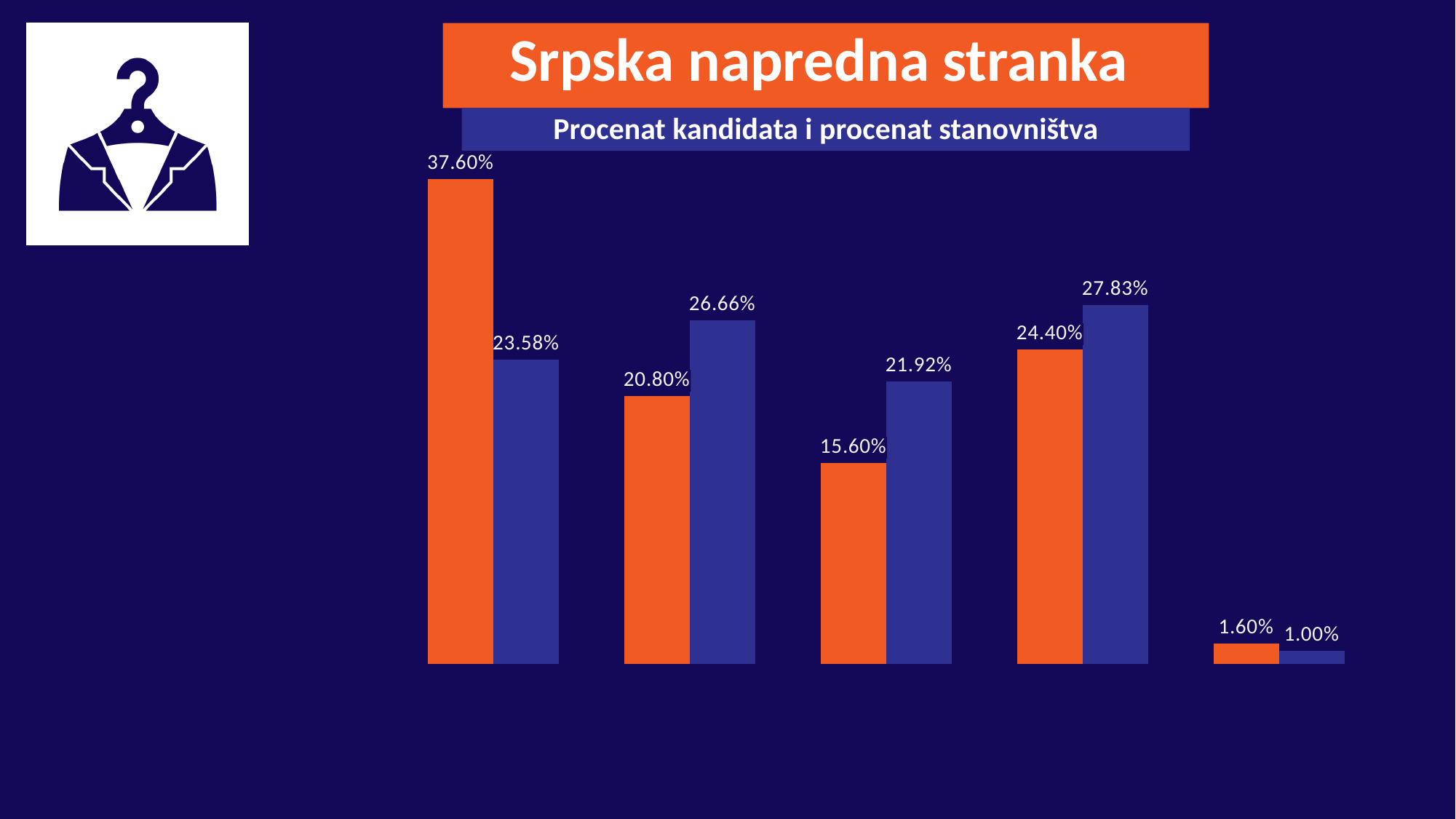
What kind of chart is shown on the slide? bar chart What is the highest value shown among the orange bars? 37.60% What is the main title shown above the chart? Srpska napredna stranka In the rightmost group, which bar is larger, the orange or the blue one? orange What is the value of the orange bar in the first (leftmost) group? 37.60% What is the value of the orange bar in the third group from the left? 15.60% What is the lowest value shown among the blue bars? 1.00% What is the value of the blue bar in the fourth group from the left? 27.83% What is the difference between the orange and blue bars in the first (leftmost) group? 14.02% In the fourth group from the left, which bar is larger, the orange or the blue one? blue What is the value of the blue bar in the second group from the left? 26.66% How many groups of bars does the chart contain? 5